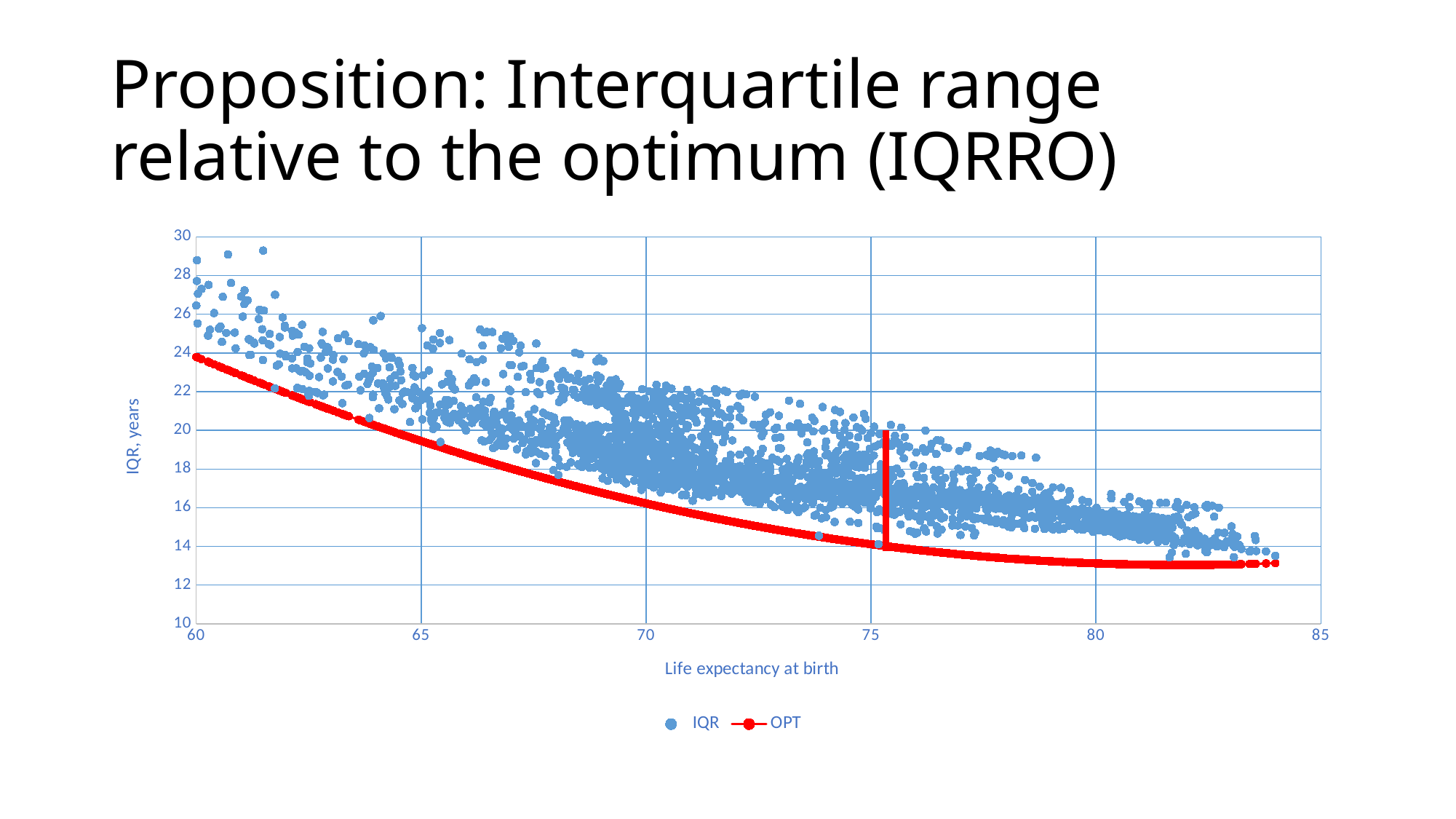
Is the OPT value at a life expectancy of 70 greater or less than 14? greater Is the OPT value at a life expectancy of 60 greater or less than 22? greater What is the label of the x axis? Life expectancy at birth What kind of chart is shown on the slide? scatter chart Is the OPT value at a life expectancy of 70 greater or less than 18? less Do the IQR values generally rise or fall as life expectancy at birth increases? fall How many series does the legend list? 2 Do the OPT values rise or fall as life expectancy at birth increases along the x axis? fall What are the names of the two series in the legend? IQR and OPT Which series has the higher value at a life expectancy of 75, IQR or OPT? IQR